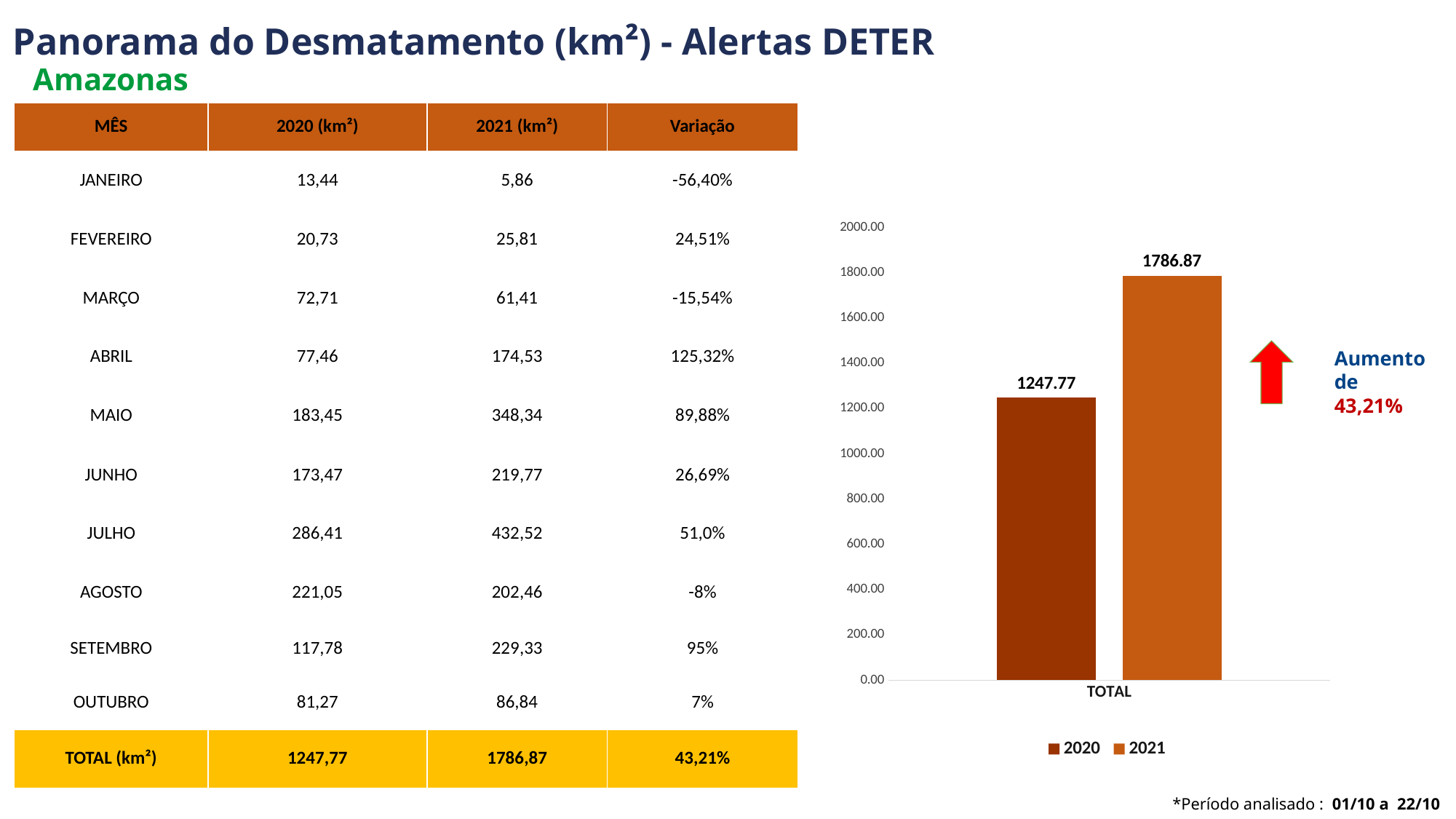
In the bar chart, what is the value of the 2020 bar? 1247.77 How many bars are plotted in the bar chart? 2 In the bar chart, which series has the lowest bar? 2020 How many series does the bar chart's legend list? 2 What type of chart is shown on the right side of the slide? bar chart In the bar chart, is the value for 2020 greater or less than 1200.00? greater What is the category label shown on the x axis of the bar chart? TOTAL In the bar chart, which series has the higher value, 2020 or 2021? 2021 In the bar chart, is the value for 2021 greater or less than 1800.00? less In the bar chart, what is the difference between the 2021 and 2020 values? 539.10 What percentage increase is annotated next to the bar chart? 43,21% In the bar chart, what is the value of the 2021 bar? 1786.87